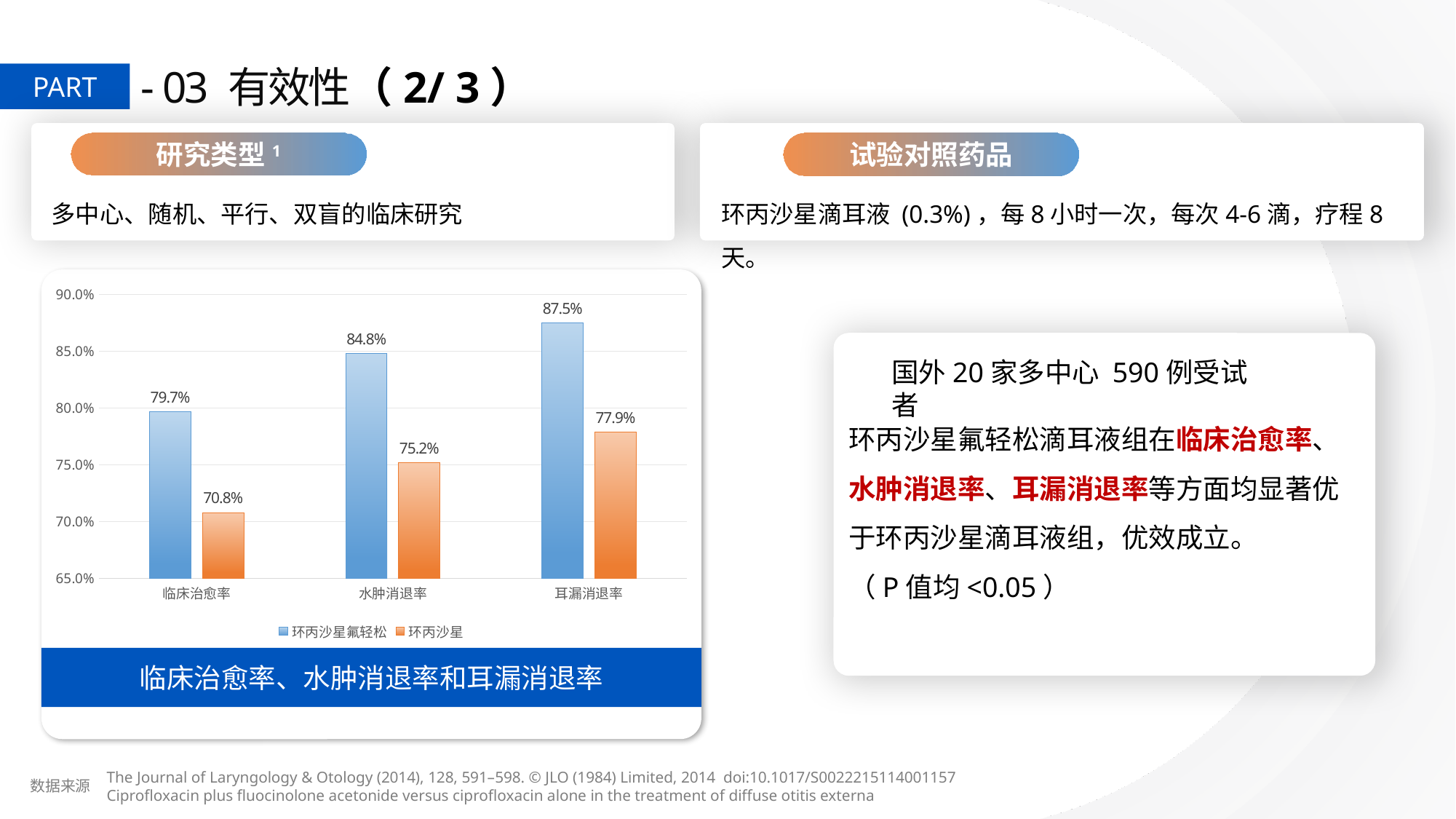
What is the value for 环丙沙星氟轻松 in the 临床治愈率 category? 79.7% Which category has the lowest value for the 环丙沙星氟轻松 series? 临床治愈率 Is the value for 环丙沙星 in the 临床治愈率 category greater or less than 75.0%? less In the 水肿消退率 category, which series has the larger value, 环丙沙星氟轻松 or 环丙沙星? 环丙沙星氟轻松 Which category has the highest value for the 环丙沙星 series? 耳漏消退率 What is the value for 环丙沙星氟轻松 in the 耳漏消退率 category? 87.5% What is the difference between 环丙沙星氟轻松 and 环丙沙星 in the 临床治愈率 category? 8.9% What kind of chart is shown on the slide? bar chart How many series does the chart legend list? 2 What is the value for 环丙沙星 in the 水肿消退率 category? 75.2% What is the difference between 环丙沙星氟轻松 and 环丙沙星 in the 耳漏消退率 category? 9.6% How many categories are shown on the x axis of the chart? 3